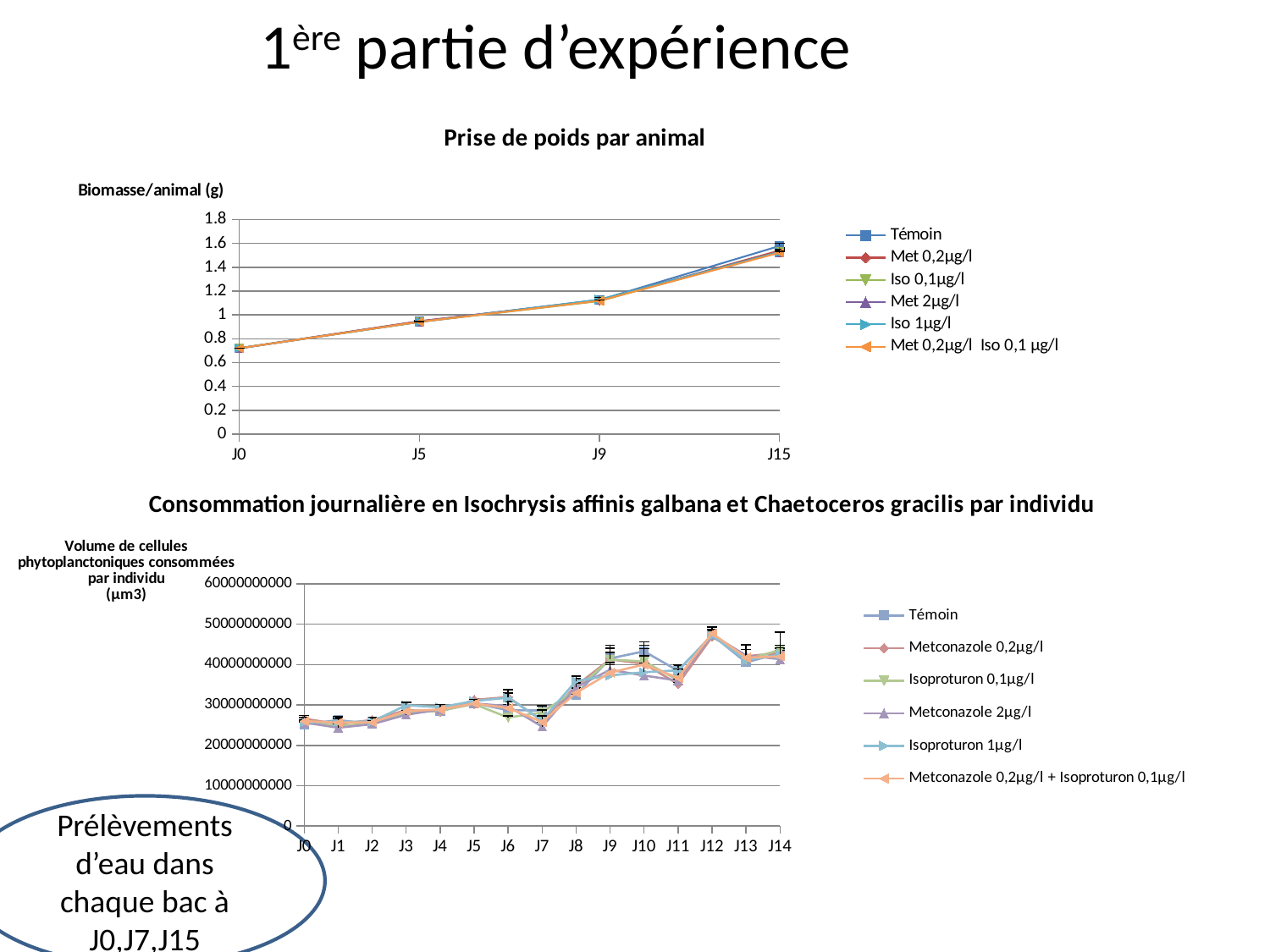
In the 'Consommation journalière' chart, how many series does the legend list? 6 What is the y-axis label of the 'Prise de poids par animal' chart? Biomasse/animal (g) In the 'Prise de poids par animal' chart, how many categories are on the x axis? 4 In the 'Prise de poids par animal' chart, is the Témoin value at J0 greater or less than 1? less In the 'Prise de poids par animal' chart, how many series does the legend list? 6 In the 'Prise de poids par animal' chart, is the Témoin value at J15 greater or less than 1.4? greater In the 'Consommation journalière' chart, how many categories are on the x axis? 15 What kind of chart is the 'Prise de poids par animal' chart? line chart In the 'Consommation journalière' chart, is the Témoin value at J1 greater or less than 30000000000? less In the 'Prise de poids par animal' chart, do the values rise or fall from J0 to J15? rise What kind of chart is the 'Consommation journalière en Isochrysis affinis galbana et Chaetoceros gracilis par individu' chart? line chart